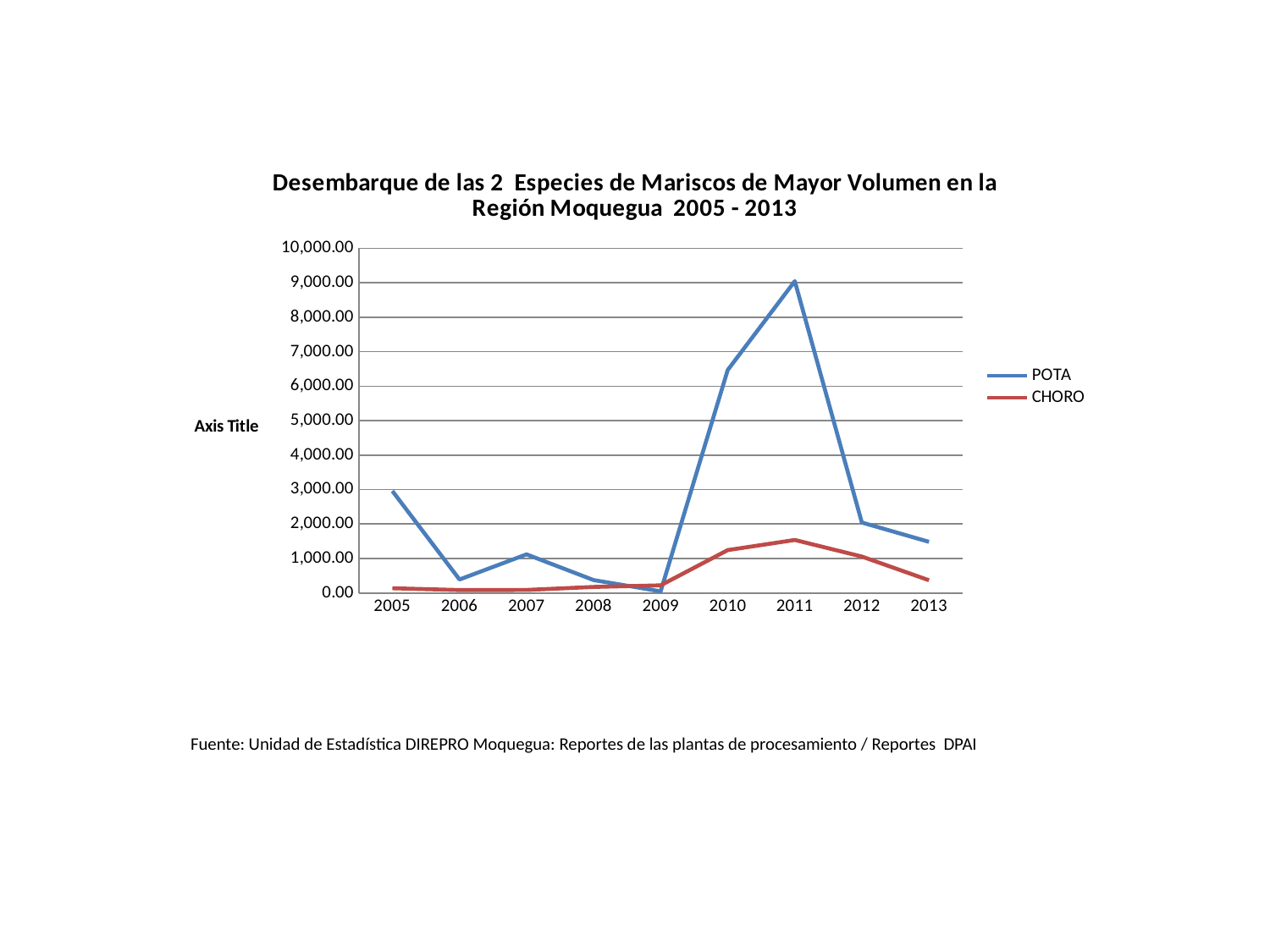
Does the POTA series rise or fall from 2011 to 2013? fall How many years are shown on the x axis? 9 Which series has the larger value in 2013, POTA or CHORO? POTA What kind of chart is shown on the slide? line chart In which year does the CHORO series reach its highest value? 2011 Is the value for CHORO in 2013 greater or less than 1,000.00? less In which year does the POTA series reach its highest value? 2011 Does the CHORO series rise or fall from 2009 to 2011? rise How many series does the legend list? 2 Which series is drawn with the red line? CHORO Is the value for POTA in 2010 greater or less than 6,000.00? greater Is the value for POTA in 2011 greater or less than 8,000.00? greater